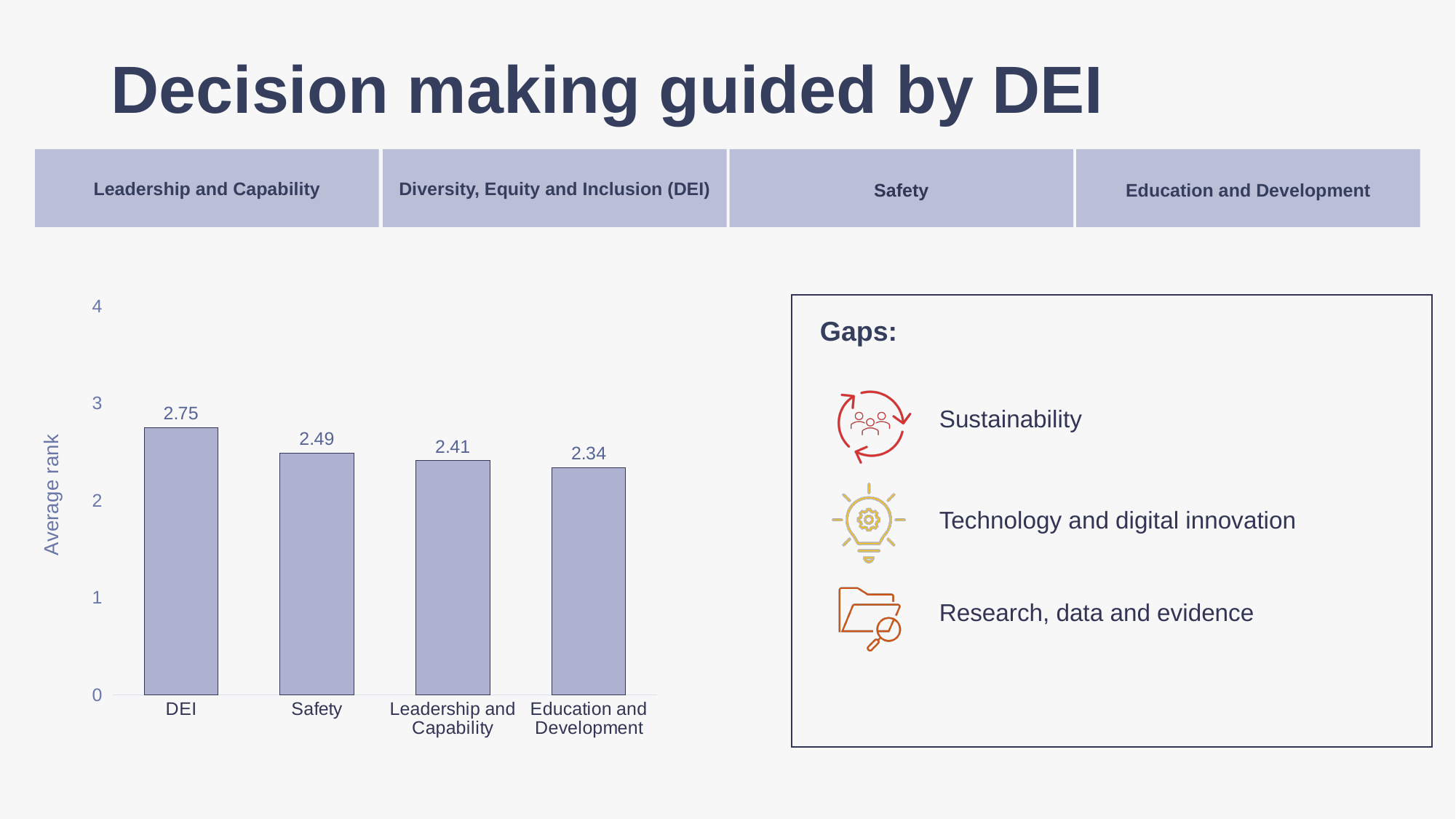
What is the difference between the average rank for DEI and for Safety? 0.26 What is the difference between the average rank for Leadership and Capability and for Education and Development? 0.07 What is the average rank for Safety? 2.49 Is the value for DEI greater or less than 3? less What is the average rank for Leadership and Capability? 2.41 What kind of chart is shown on the slide? bar chart What is the average rank for DEI? 2.75 Which category has the lowest average rank? Education and Development How many categories are shown on the chart? 4 Which has a higher average rank, Safety or Education and Development? Safety Which category has the highest average rank? DEI What is the average rank for Education and Development? 2.34